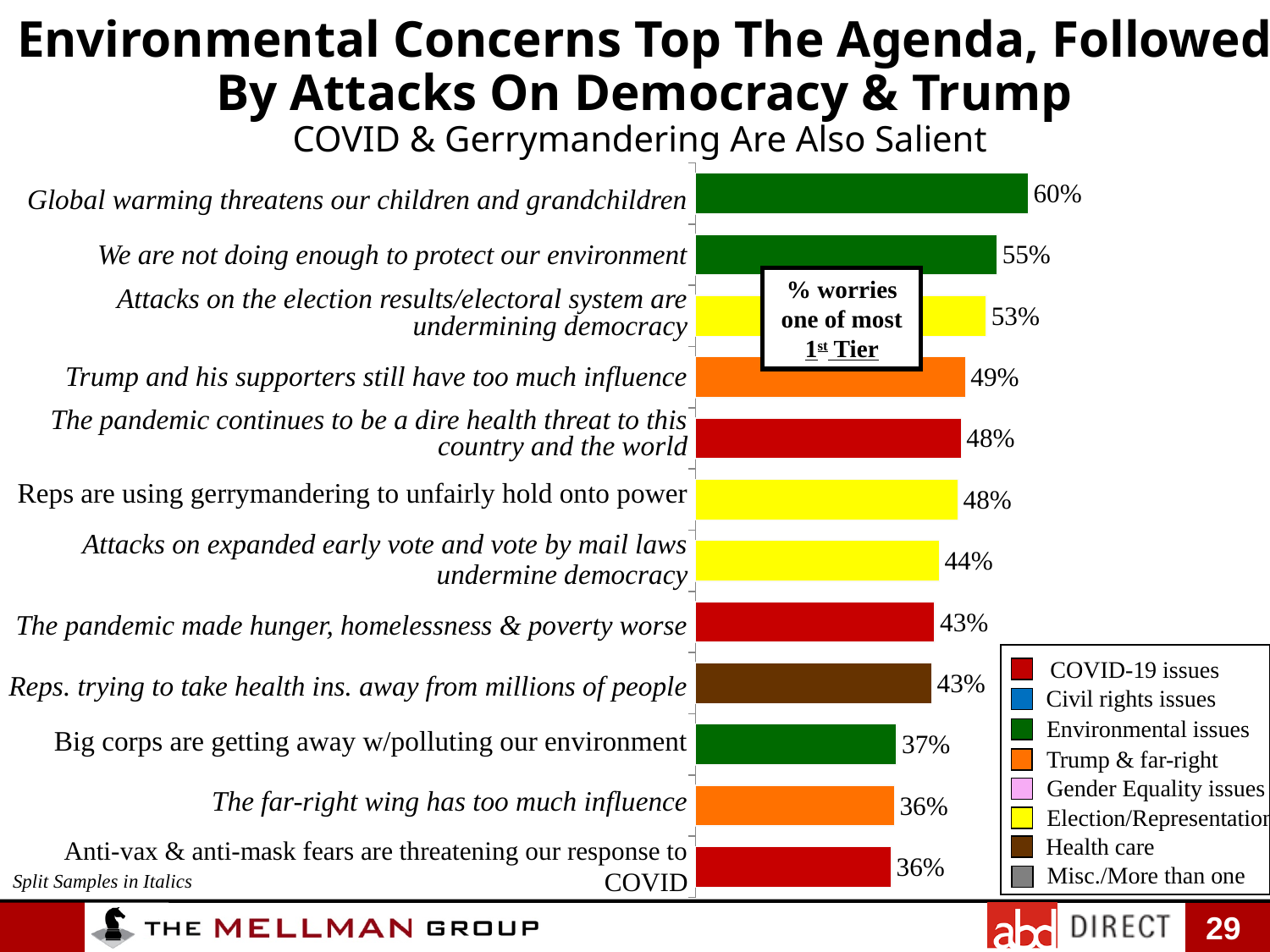
What is the value for "Trump and his supporters still have too much influence"? 49% What kind of chart is shown on the slide? Bar chart What percentage worries about "Global warming threatens our children and grandchildren"? 60% Which is larger: "Attacks on the election results/electoral system are undermining democracy" or "Attacks on expanded early vote and vote by mail laws undermine democracy"? Attacks on the election results/electoral system are undermining democracy According to the legend, what colour represents Environmental issues? Green How many bars are plotted on the chart? 12 What percentage is shown for "Reps are using gerrymandering to unfairly hold onto power"? 48% Which item has the highest percentage? Global warming threatens our children and grandchildren What is the lowest percentage shown on the chart? 36% What is the value for "Big corps are getting away w/polluting our environment"? 37% How many entries does the legend list? 8 What is the difference between "Global warming threatens our children and grandchildren" and "We are not doing enough to protect our environment"? 5%